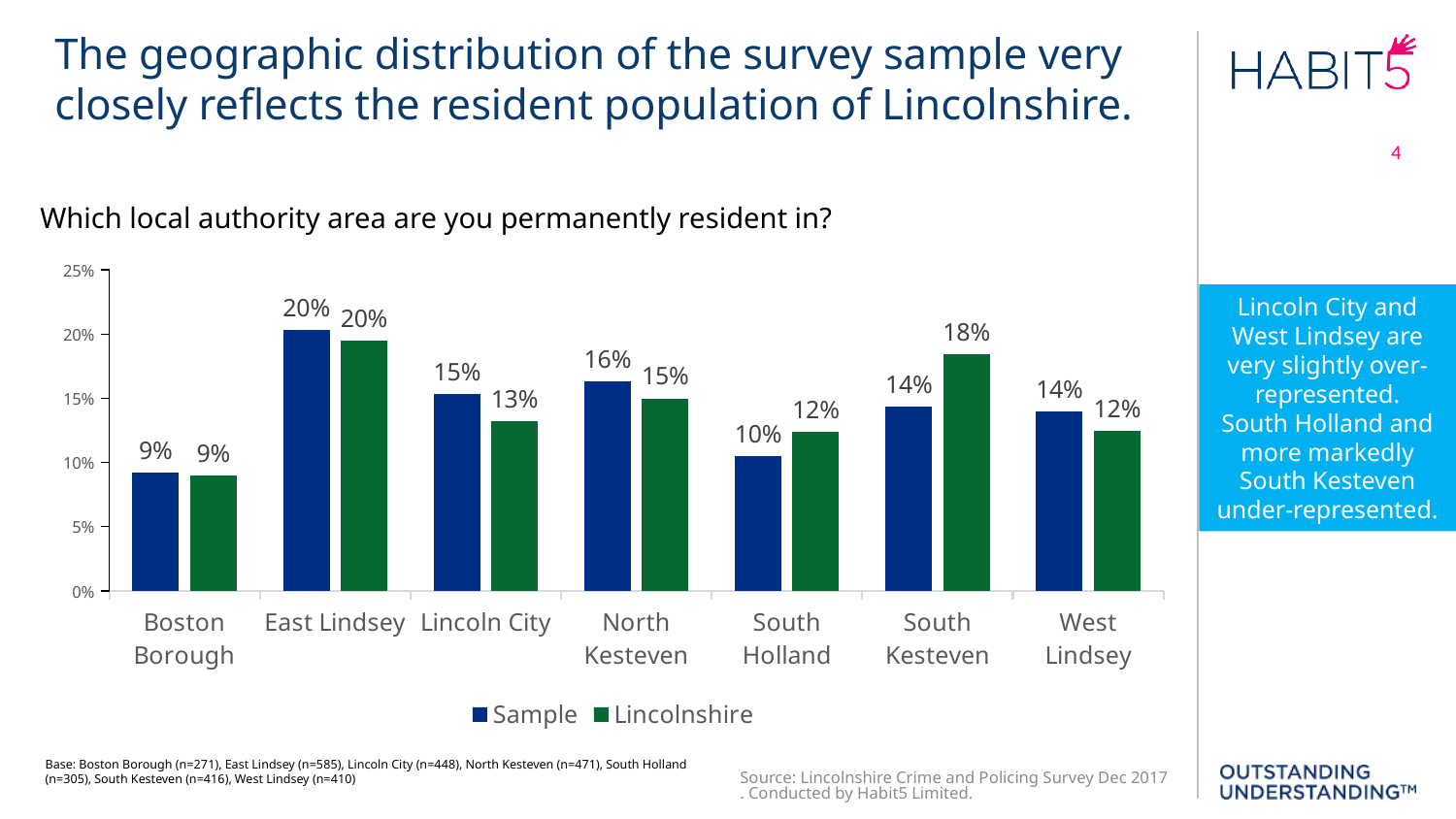
What kind of chart is shown on the slide? Bar chart What is the difference between the Lincolnshire and Sample values for South Kesteven? 4 percentage points Is the Sample value for Boston Borough greater or less than 10%? less For West Lindsey, which is larger: the Sample value or the Lincolnshire value? Sample How many local authority areas are shown on the x axis? 7 Which local authority area has the highest Sample value? East Lindsey What is the Lincolnshire value for Lincoln City? 13% How many series does the legend list? 2 What is the Sample value for South Kesteven? 14% Which local authority area has the lowest Lincolnshire value? Boston Borough What is the Sample value for North Kesteven? 16% Which series is shown in green in the legend? Lincolnshire